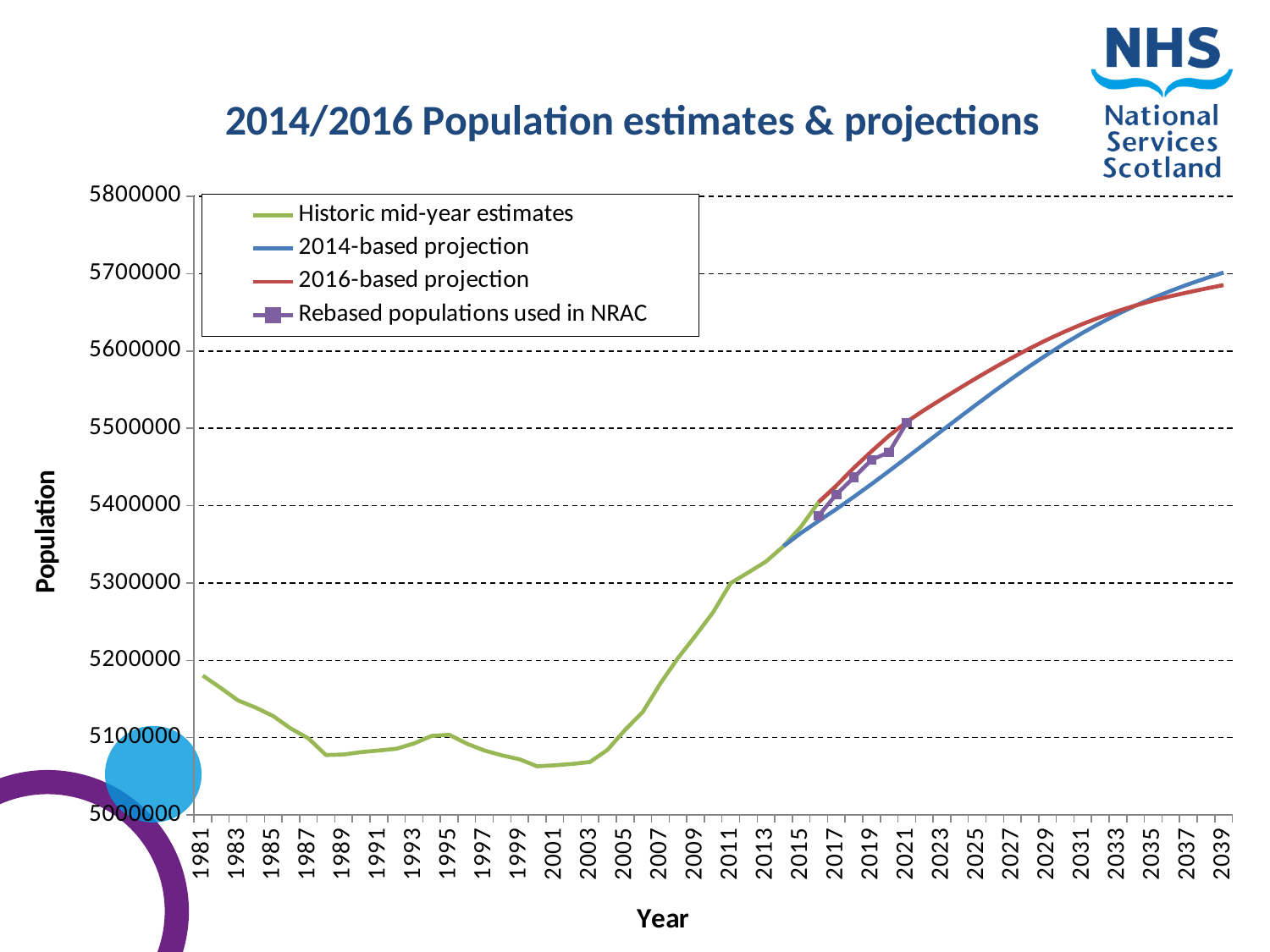
Is the historic mid-year estimate for 2001 greater or less than 5100000? less Which series is drawn with square markers? Rebased populations used in NRAC What kind of chart is shown on the slide? Line chart How many series does the legend list? 4 What is the title of the chart? 2014/2016 Population estimates & projections How many year labels are shown on the x axis? 30 Do the historic mid-year estimates rise or fall between 2003 and 2015? rise In 2025, which is higher: the 2014-based projection or the 2016-based projection? 2016-based projection Is the historic mid-year estimate for 1981 greater or less than 5100000? greater Do the historic mid-year estimates rise or fall between 1981 and 1987? fall Is the 2016-based projection for 2025 greater or less than 5500000? greater In 2039, which is higher: the 2014-based projection or the 2016-based projection? 2014-based projection